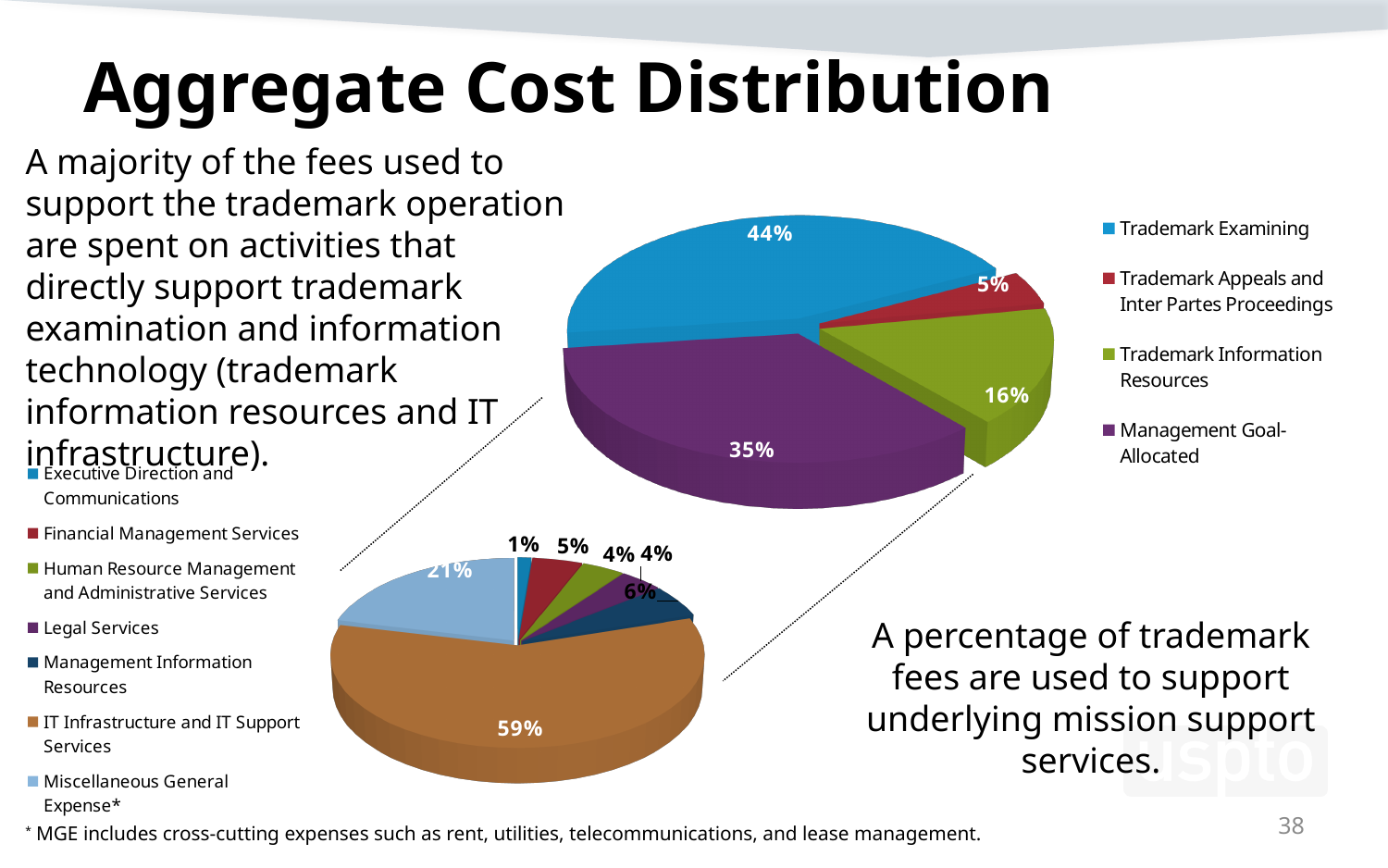
On the upper pie chart, what share is Trademark Examining? 44% On the lower pie chart, which category has the smallest share? Executive Direction and Communications What type of chart is used for the two charts on this slide? Pie chart On the upper pie chart, what is the difference between the Trademark Examining share and the Management Goal-Allocated share? 9% On the lower pie chart, what share is IT Infrastructure and IT Support Services? 59% On the upper pie chart, what share is Trademark Information Resources? 16% How many categories does the legend of the upper pie chart list? 4 On the upper pie chart, which category has the smallest share? Trademark Appeals and Inter Partes Proceedings On the lower pie chart, which category has the largest share? IT Infrastructure and IT Support Services How many categories does the legend of the lower pie chart list? 7 On the lower pie chart, what share is Miscellaneous General Expense? 21% On the upper pie chart, what share is Management Goal-Allocated? 35%